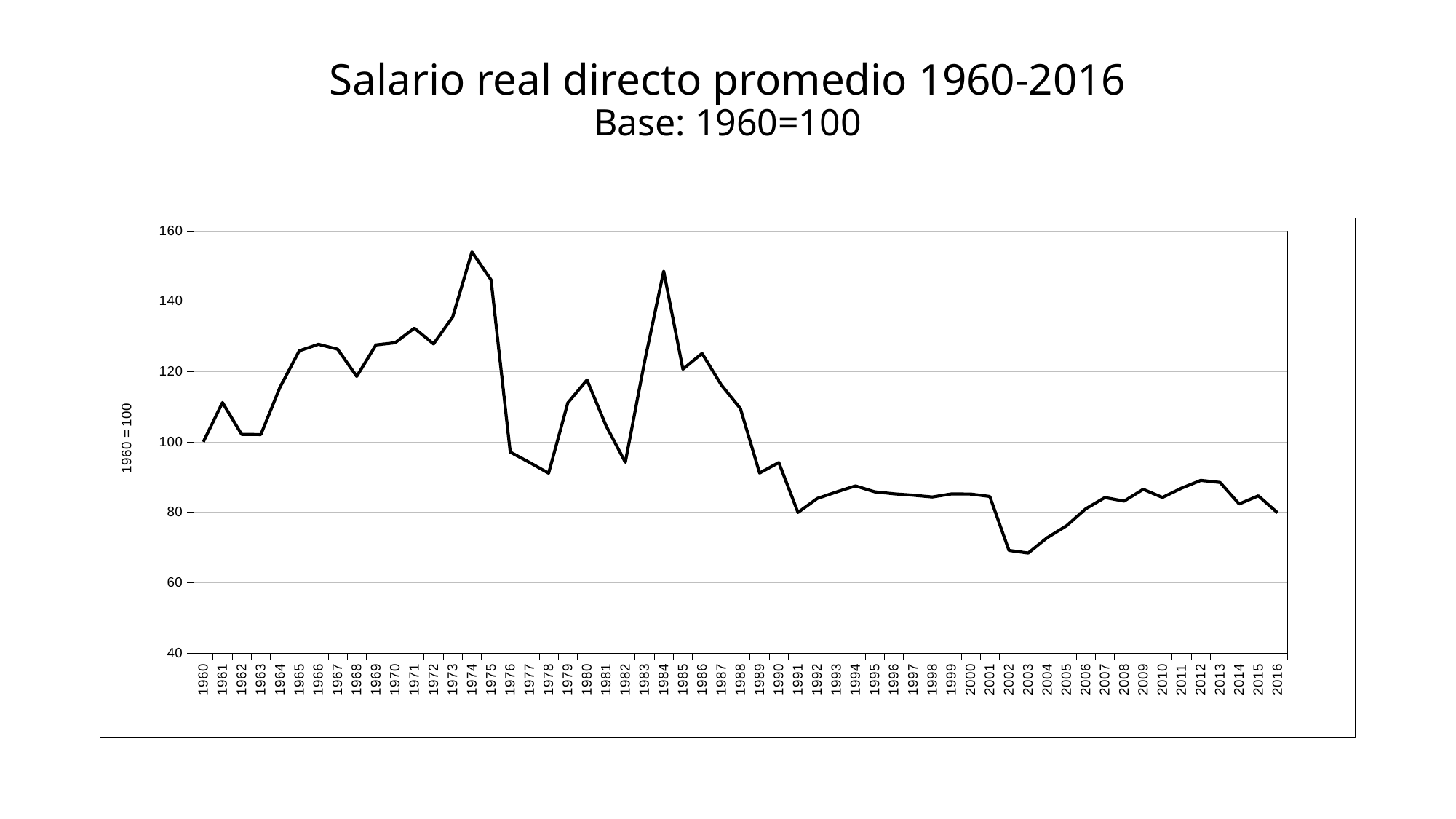
Which year has the lowest value? 2003 Is the value for 1966 greater or less than 120? greater Which is larger, the value for 1974 or the value for 1984? 1974 What is the title of the chart? Salario real directo promedio 1960-2016 Overall, does the value rise or fall from 1960 to 2016? fall What type of chart is shown on the slide? line chart Is the value for 1978 greater or less than 100? less What is the value for 1960? 100 How many years are plotted on the x axis? 57 Which year has the highest value? 1974 Is the value for 1974 greater or less than 140? greater